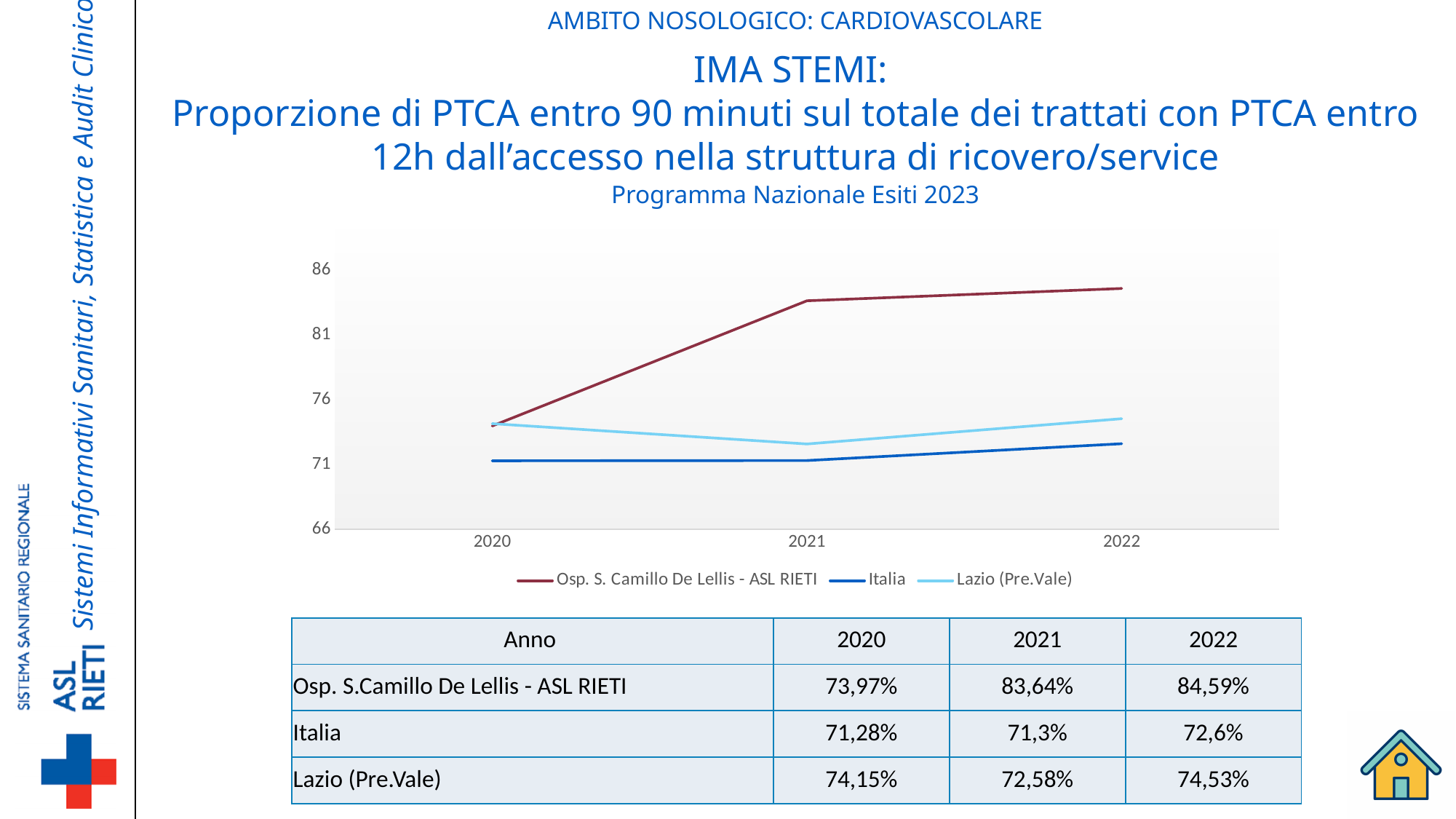
Which series has the lowest value in 2021? Italia Which is larger in 2020: the value for Lazio (Pre.Vale) or the value for Osp. S. Camillo De Lellis - ASL RIETI? Lazio (Pre.Vale) What is the value for Lazio (Pre.Vale) in 2021? 72,58% How many series does the chart legend list? 3 What kind of chart is shown on the slide? line chart Does the Osp. S. Camillo De Lellis - ASL RIETI line rise or fall from 2020 to 2022? rise What is the value for Osp. S. Camillo De Lellis - ASL RIETI in 2022? 84,59% What is the difference between the Osp. S. Camillo De Lellis - ASL RIETI value in 2021 and in 2020? 9,67% How many years are plotted along the x axis of the chart? 3 Which series has the highest value in 2022? Osp. S. Camillo De Lellis - ASL RIETI Is the value for Osp. S. Camillo De Lellis - ASL RIETI in 2021 greater or less than 81? greater What is the value for Italia in 2020? 71,28%